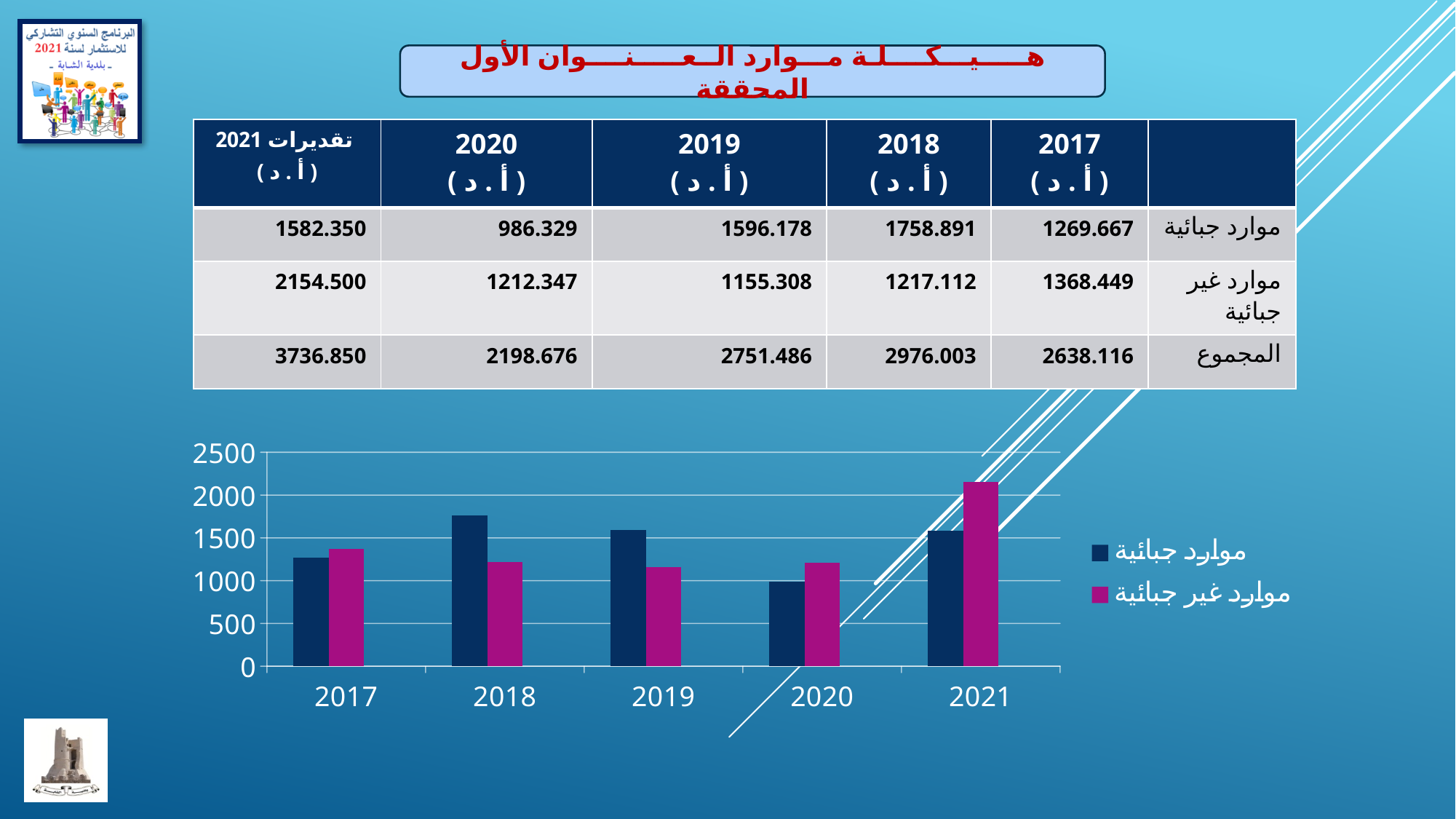
Is the value for موارد جبائية in 2020 greater or less than 1500? less Do the bars for موارد جبائية rise or fall from 2018 to 2020? fall In 2018, which series has the larger bar, موارد جبائية or موارد غير جبائية? موارد جبائية In 2021, which series has the larger bar, موارد جبائية or موارد غير جبائية? موارد غير جبائية How many series does the chart legend list? 2 Which colour represents موارد غير جبائية in the chart? magenta What kind of chart is shown on the slide? bar chart Is the value for موارد غير جبائية in 2021 greater or less than 2000? greater In which year is the bar for موارد جبائية the lowest? 2020 How many years are shown on the x axis of the chart? 5 In which year is the bar for موارد غير جبائية the highest? 2021 In which year is the bar for موارد جبائية the highest? 2018